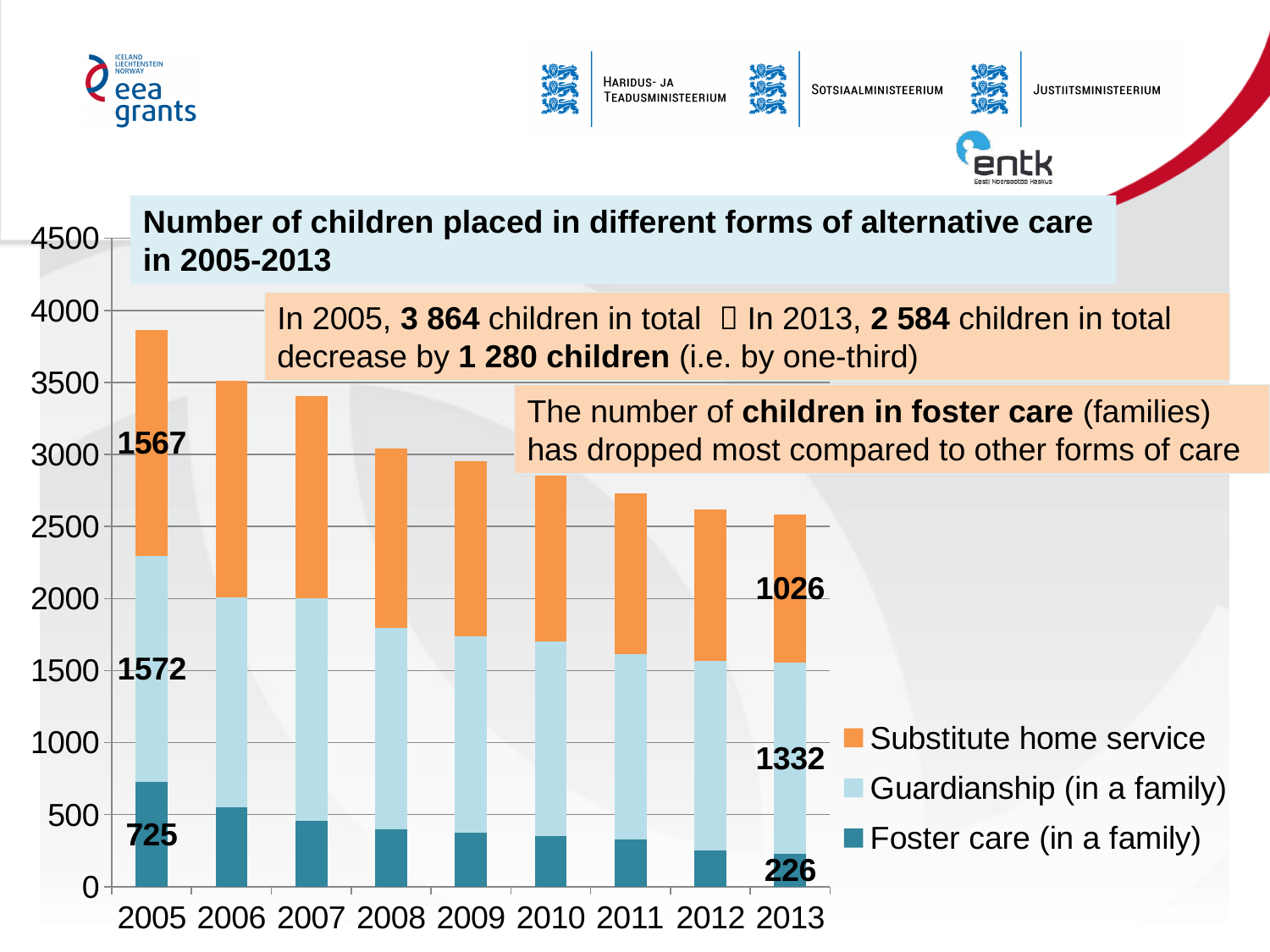
What is the total number of children across all three forms of care in 2005? 3 864 Which year has the highest total bar? 2005 How many series does the legend list? 3 What is the value for Guardianship (in a family) in 2013? 1332 What is the difference between Guardianship (in a family) in 2005 and in 2013? 240 Which year has the lowest total bar? 2013 By how much did the number of children in Foster care (in a family) fall between 2005 and 2013? 499 How many years are shown on the x axis? 9 What is the value for Substitute home service in 2005? 1567 What is the value for Foster care (in a family) in 2005? 725 Is the total value for 2008 greater or less than 3500? less What is the value for Substitute home service in 2013? 1026